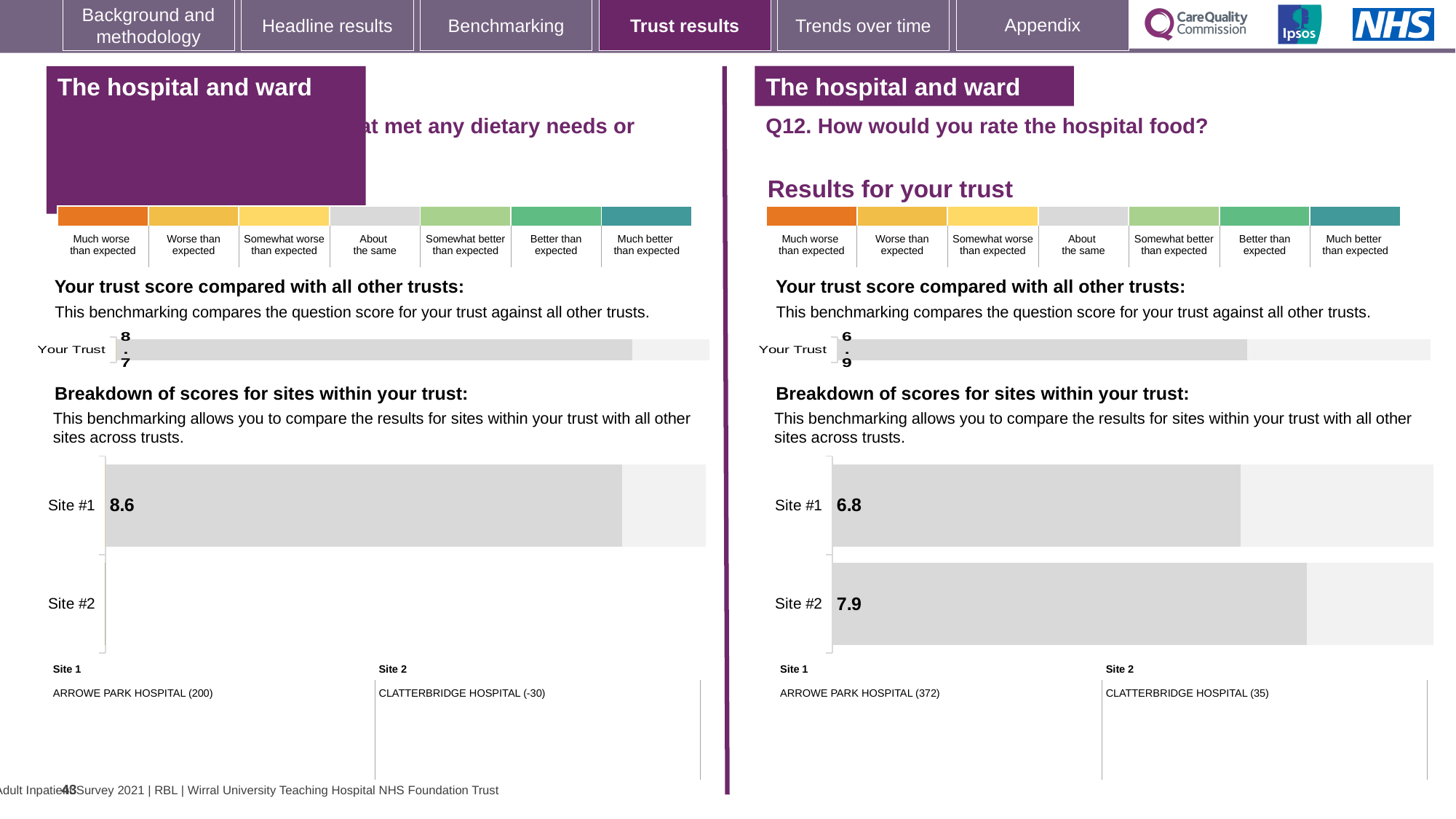
On the right-hand chart for Q12 (hospital food), which site has the higher score, Site #1 or Site #2? Site #2 On the right-hand chart for Q12 (hospital food), what is the score for Site #2? 7.9 On the right-hand chart for Q12 (hospital food), what is the score shown for Your Trust? 6.9 On the right-hand chart for Q12 (hospital food), what is the score for Site #1? 6.8 What kind of chart is used to show the breakdown of scores for sites within your trust on the right-hand side? Bar chart On the left-hand chart (dietary needs question), what is the score for Site #1? 8.6 On the left-hand chart (dietary needs question), how many sites are listed in the site breakdown? 2 On the left-hand chart (dietary needs question), what is the score shown for Your Trust? 8.7 Which trust score is higher: Your Trust on the left-hand chart (8.7) or Your Trust on the right-hand Q12 chart (6.9)? Left-hand chart (8.7) On the right-hand chart for Q12 (hospital food), what is the difference between the Site #2 score and the Site #1 score? 1.1 On the right-hand chart for Q12 (hospital food), which site is named as Site 1? ARROWE PARK HOSPITAL (372) On the left-hand chart (dietary needs question), which site is named as Site 2? CLATTERBRIDGE HOSPITAL (-30)